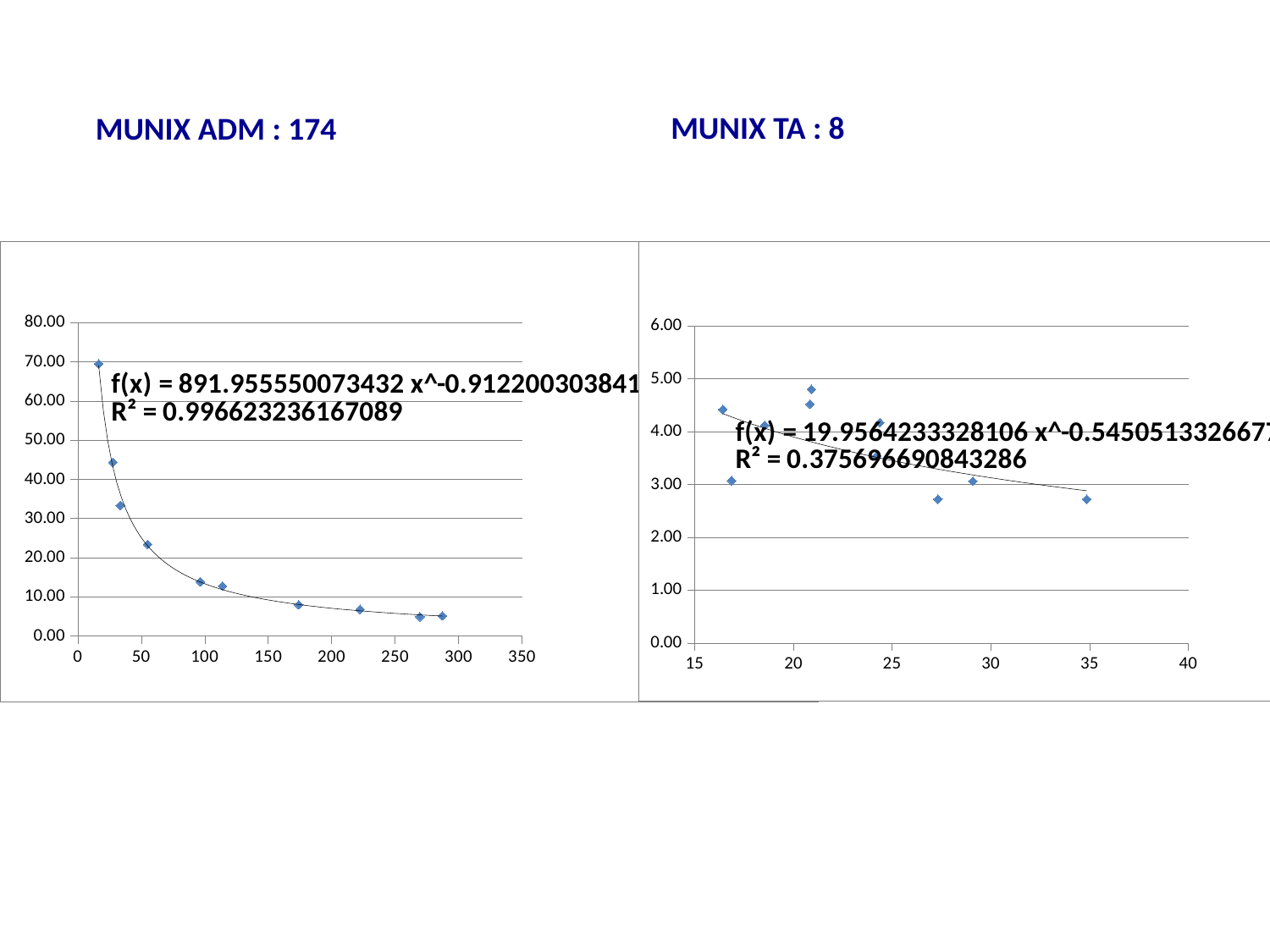
How many data points are plotted on the left chart (MUNIX ADM : 174)? 10 On the right chart (MUNIX TA : 8), is the y value of the point near x=35 greater or less than 3.00? less On the left chart (MUNIX ADM : 174), is the y value of the highest point greater or less than 60.00? greater What R² value is shown on the right chart (MUNIX TA : 8)? 0.375696690843286 On the right chart (MUNIX TA : 8), does the fitted trendline rise or fall as x increases? fall What kind of chart is the left chart (MUNIX ADM : 174)? scatter chart On the left chart (MUNIX ADM : 174), do the y values rise or fall as x increases? fall On the left chart (MUNIX ADM : 174), is the y value of the point near x=290 greater or less than 10.00? less What R² value is shown on the left chart (MUNIX ADM : 174)? 0.996623236167089 On the left chart (MUNIX ADM : 174), which has the larger y value: the point near x=55 or the point near x=95? the point near x=55 What kind of chart is the right chart (MUNIX TA : 8)? scatter chart